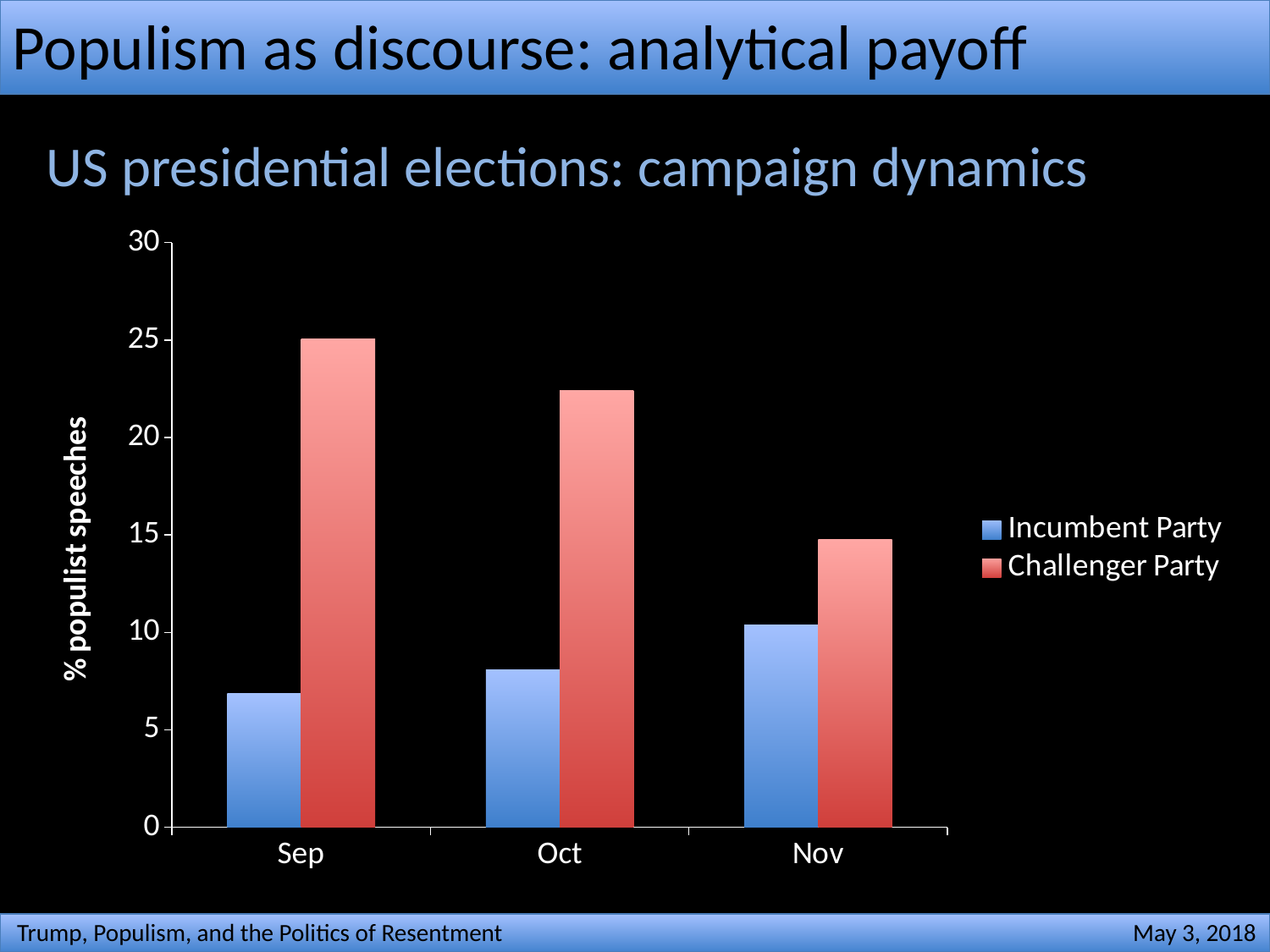
Do the Incumbent Party values rise or fall from Sep to Nov? rise Which month has the lowest value for the Incumbent Party? Sep How many months are shown on the x axis of the chart? 3 Do the Challenger Party values rise or fall from Sep to Nov? fall What is the label on the chart's vertical axis? % populist speeches Which month has the highest value for the Incumbent Party? Nov Is the value for the Incumbent Party in Sep greater or less than 10? less What kind of chart is shown on the slide? bar chart Is the value for the Challenger Party in Oct greater or less than 20? greater Which month has the highest value for the Challenger Party? Sep In Oct, which series has the larger value, Incumbent Party or Challenger Party? Challenger Party How many series does the chart's legend list? 2